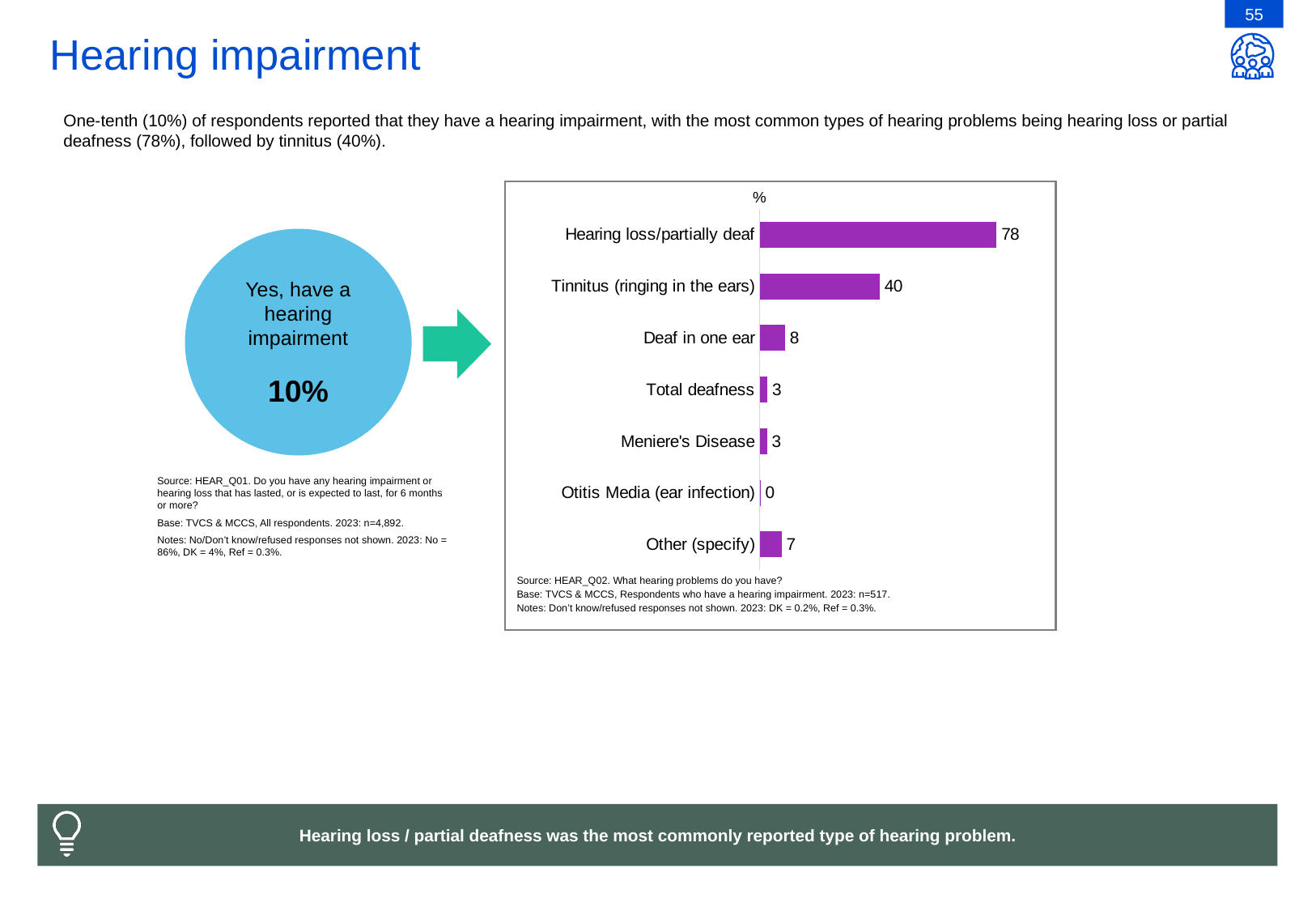
What is the value for Hearing loss/partially deaf in the bar chart? 78 Which category has the lowest value in the bar chart? Otitis Media (ear infection) What is the value for Deaf in one ear in the bar chart? 8 Which is larger in the bar chart: Deaf in one ear or Other (specify)? Deaf in one ear What is the difference between the values for Hearing loss/partially deaf and Tinnitus (ringing in the ears)? 38 What is the difference between the values for Other (specify) and Total deafness? 4 Which category has the highest value in the bar chart? Hearing loss/partially deaf How many categories are shown in the bar chart? 7 What percentage is shown in the blue circle for respondents who have a hearing impairment? 10% What is the value for Tinnitus (ringing in the ears) in the bar chart? 40 What kind of chart shows the types of hearing problems? Bar chart What is the value for Otitis Media (ear infection) in the bar chart? 0